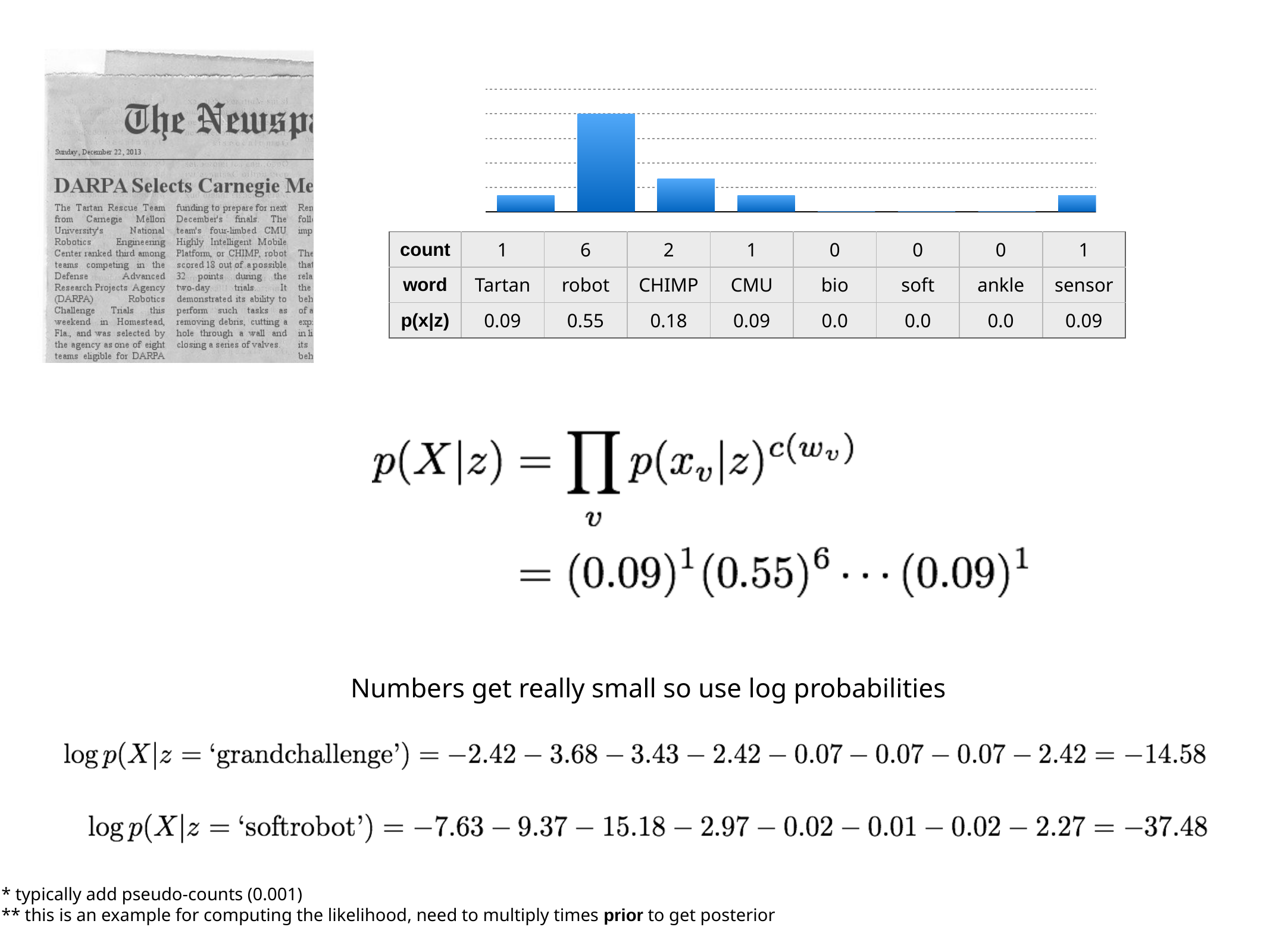
What is the difference between the count for robot and the count for CHIMP? 4 What is p(x|z) for the word robot? 0.55 What is p(x|z) for the word CHIMP? 0.18 What is the count for the word robot? 6 Which has a larger count, Tartan or CHIMP? CHIMP What colour are the bars in the chart? blue Which word has the highest bar in the chart? robot How many words (bars) are shown in the chart? 8 What is the count for the word CHIMP? 2 What kind of chart is shown at the top of the slide? bar chart What is the count for the word sensor? 1 How many words have a count of 0 in the chart? 3